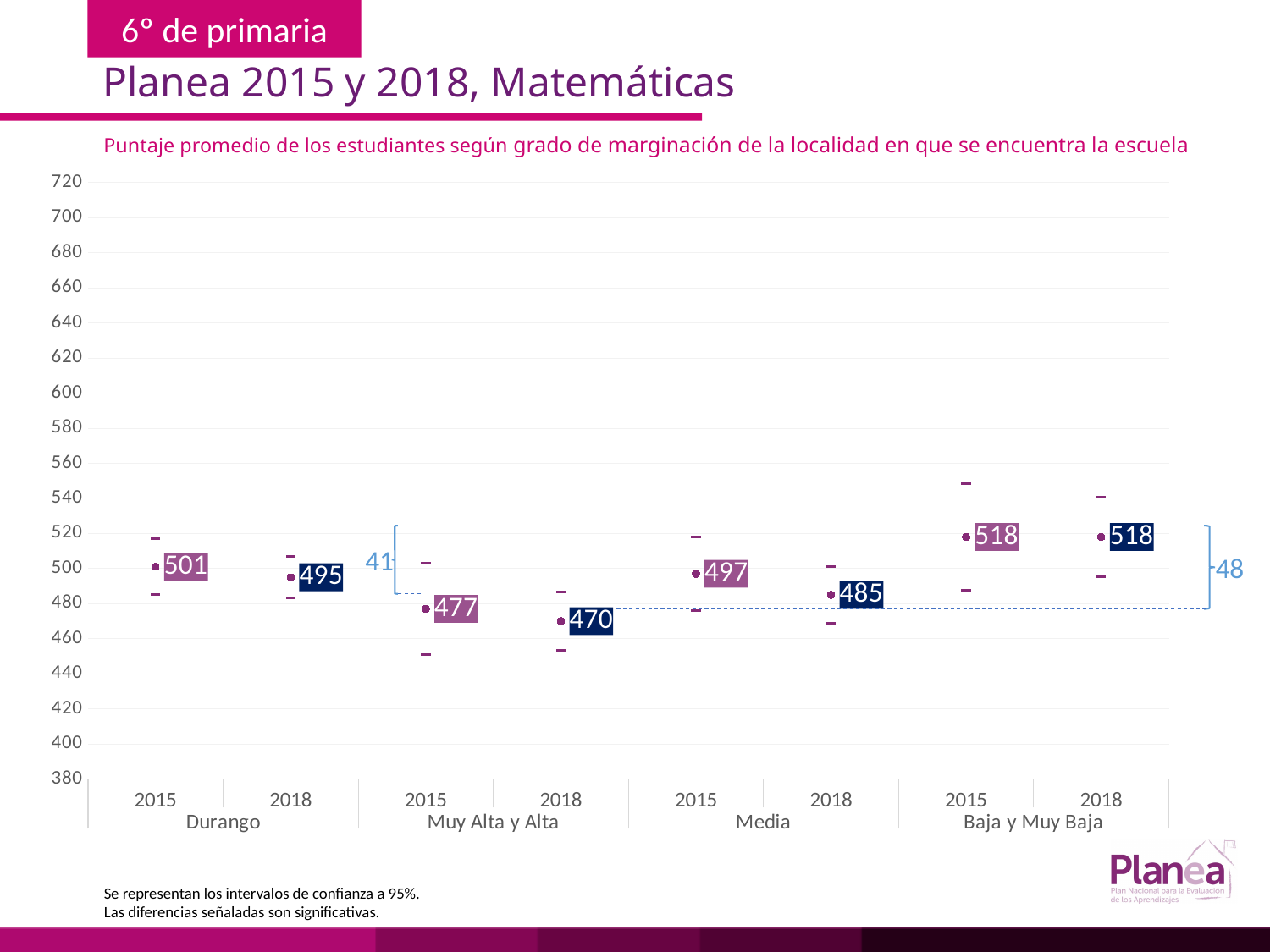
Which is larger, the 2015 average score for Durango or the 2015 average score for the Media group? Durango What is the difference between the Durango average score in 2015 and in 2018? 6 What is the average score for the Baja y Muy Baja group in 2015? 518 What is the average score for the Muy Alta y Alta marginación group in 2018? 470 What is the difference between the Media group's average score in 2015 and in 2018? 12 How many marginación groups (including Durango) are shown on the x axis? 4 What is the average score for the Media group in 2018? 485 Which group and year has the lowest average score? Muy Alta y Alta, 2018 Which marginación group has the highest average scores in both 2015 and 2018? Baja y Muy Baja Did the average score for the Baja y Muy Baja group rise, fall or stay the same from 2015 to 2018? Stayed the same What difference is annotated between the Baja y Muy Baja and Muy Alta y Alta groups for 2018? 48 What is the average score for Durango in 2015? 501